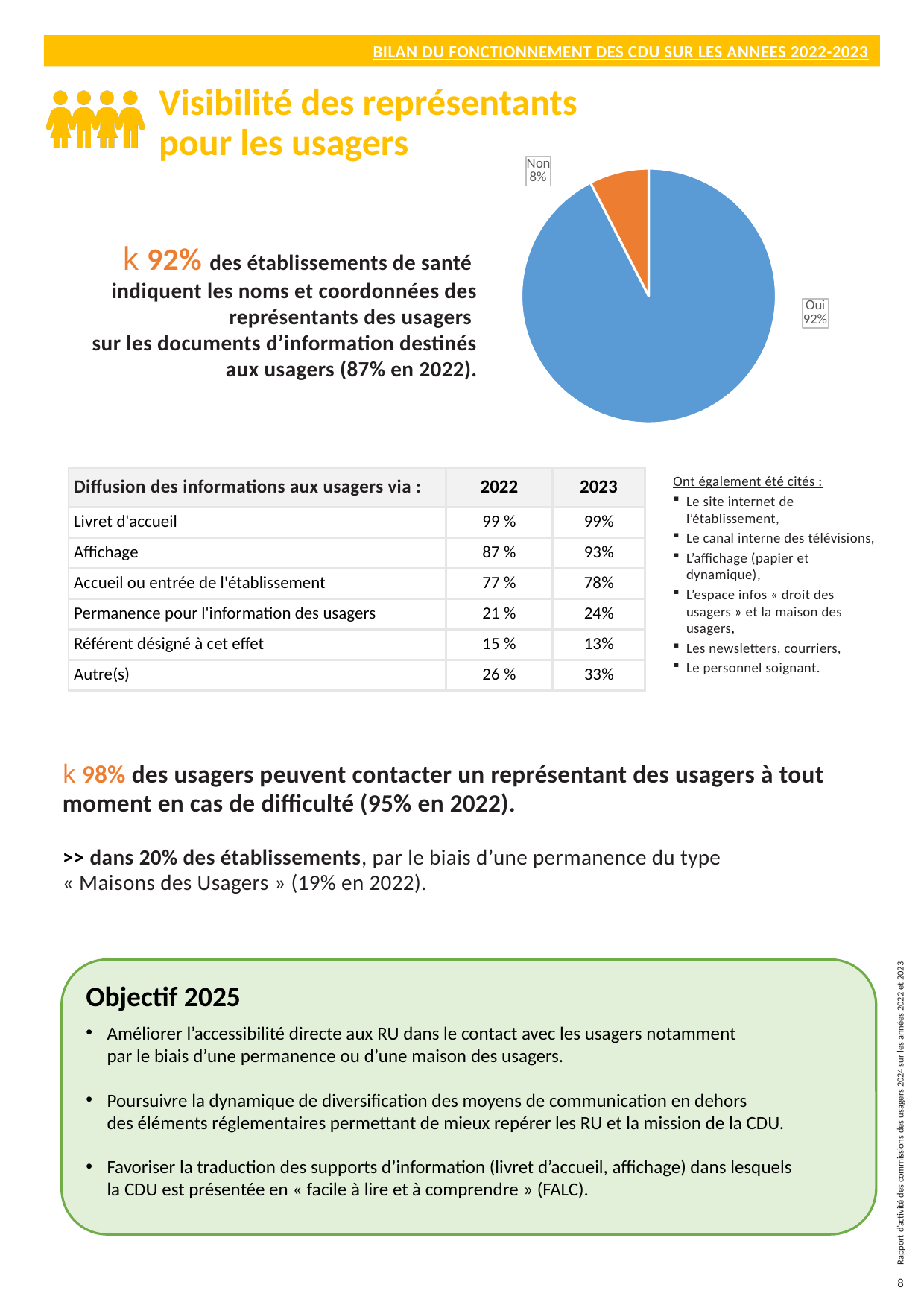
What is the value of the "Oui" slice in the pie chart? 92% What colour is the "Oui" slice in the pie chart? Blue What is the value of the "Non" slice in the pie chart? 8% What kind of chart is shown on the slide? Pie chart Which slice of the pie chart is the smallest? Non What colour is the "Non" slice in the pie chart? Orange Which is larger in the pie chart, "Oui" or "Non"? Oui How many slices does the pie chart have? 2 What share of the pie does the "Oui" slice represent? 92% Which slice of the pie chart is the largest? Oui What is the difference in percentage points between the "Oui" and "Non" slices? 84 percentage points